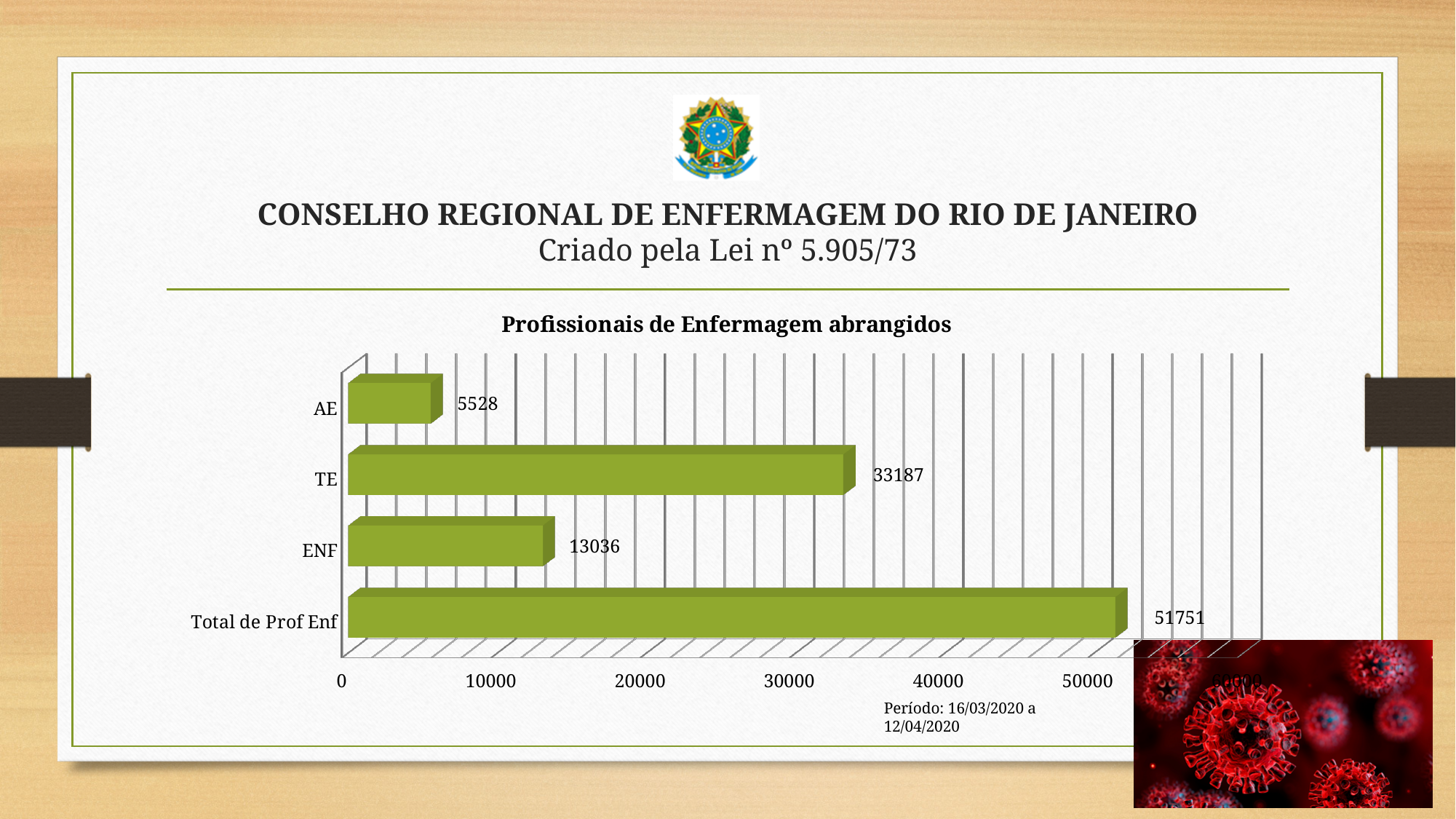
Which is larger, the value for ENF or the value for AE? ENF What is the value for ENF? 13036 What is the title of the chart? Profissionais de Enfermagem abrangidos Is the value for TE greater or less than 30000? greater Which category has the highest value? Total de Prof Enf What is the value for TE? 33187 How many categories are shown in the chart? 4 What is the difference between the values for TE and ENF? 20151 What is the value for AE? 5528 What kind of chart is shown on the slide? bar chart What is the value for Total de Prof Enf? 51751 Which category has the lowest value? AE